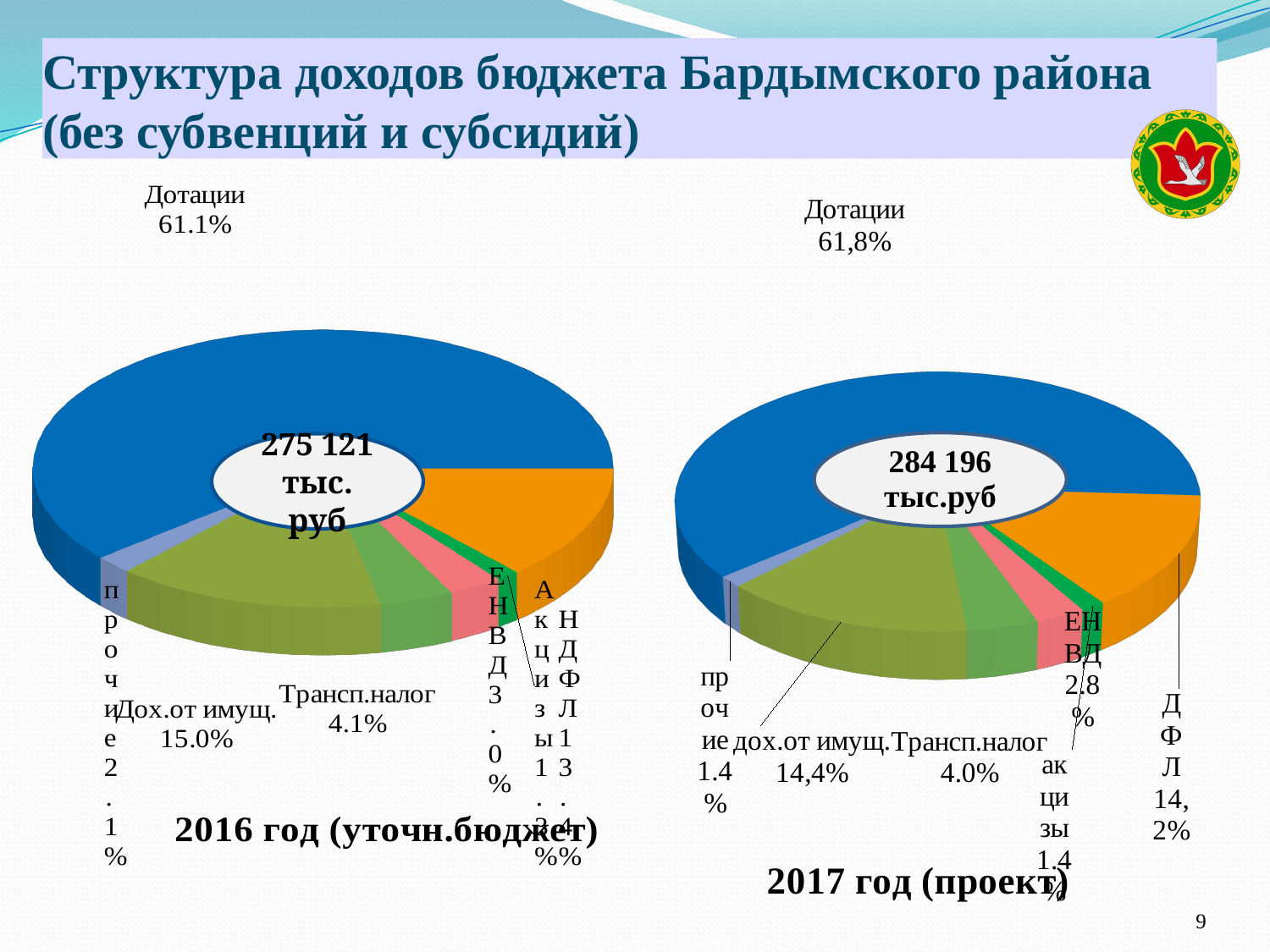
What total amount is printed in the centre of the 2017 год (проект) chart? 284 196 тыс.руб In the 2016 год (уточн.бюджет) chart, which is larger: Дох.от имущ. or Трансп.налог? Дох.от имущ. In the 2017 год (проект) chart, what share is shown for Дотации? 61,8% In the 2016 год (уточн.бюджет) chart, what share is shown for Дох.от имущ.? 15.0% In the 2017 год (проект) chart, what share is shown for Трансп.налог? 4.0% In the 2017 год (проект) chart, what share is shown for ЕНВД? 2.8% What total amount is printed in the centre of the 2016 год (уточн.бюджет) chart? 275 121 тыс.руб What type of chart is used for the 2016 год (уточн.бюджет) chart? pie chart Which category has the largest slice in the 2017 год (проект) chart? Дотации What is the difference between the Дотации share in the 2017 год (проект) chart and the Дотации share in the 2016 год (уточн.бюджет) chart? 0.7 percentage points In the 2017 год (проект) chart, what share is shown for НДФЛ? 14,2% In the 2016 год (уточн.бюджет) chart, what share is shown for Дотации? 61.1%